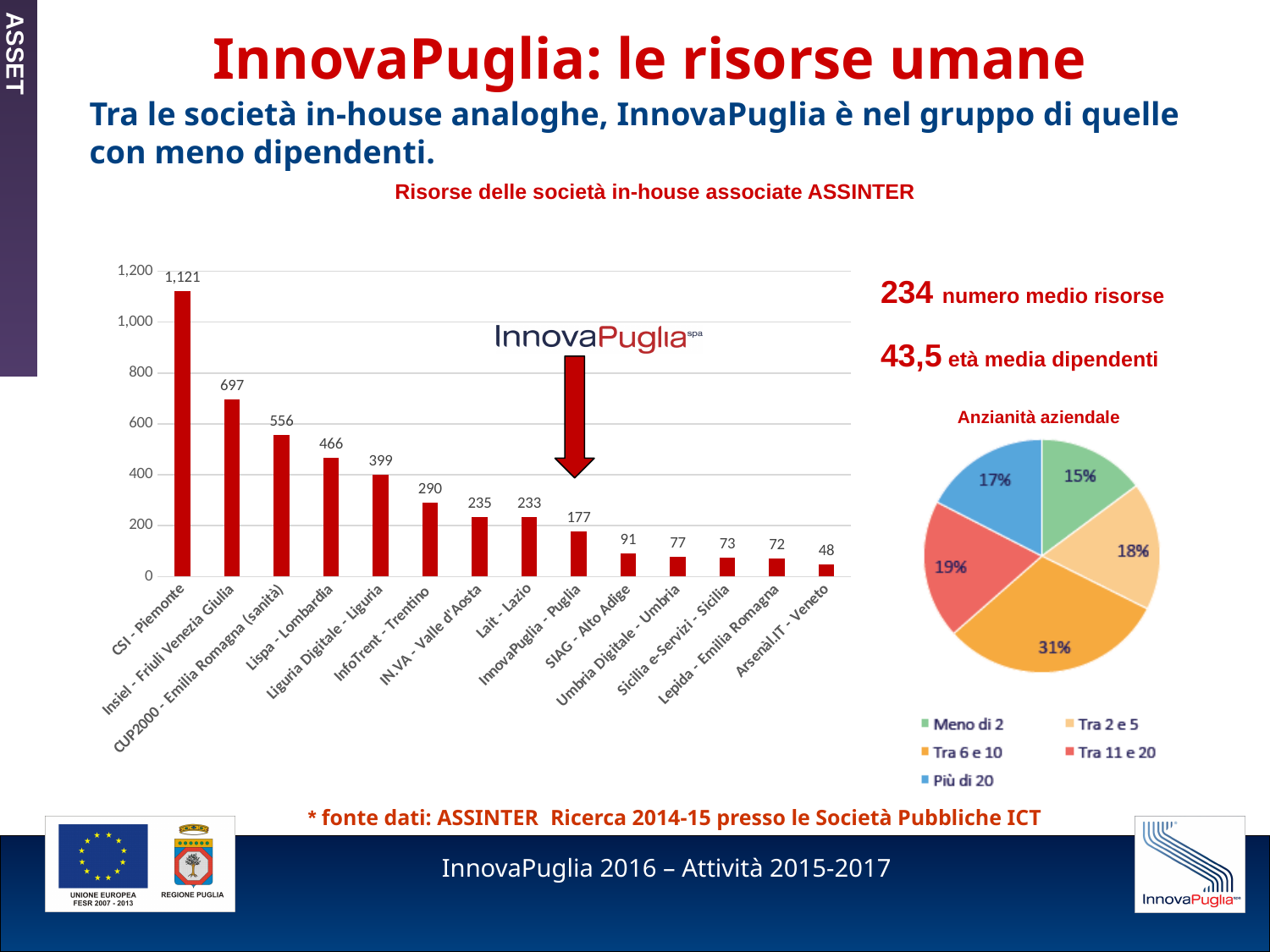
In the bar chart 'Risorse delle società in-house associate ASSINTER', which company has the lowest value? Arsenàl.IT - Veneto What kind of chart is 'Risorse delle società in-house associate ASSINTER'? Bar chart In the bar chart 'Risorse delle società in-house associate ASSINTER', what is the value for Lait - Lazio? 233 In the pie chart 'Anzianità aziendale', which category has the smallest share? Meno di 2 In the bar chart 'Risorse delle società in-house associate ASSINTER', what is the value for InnovaPuglia - Puglia? 177 In the bar chart 'Risorse delle società in-house associate ASSINTER', how many companies are shown? 14 In the bar chart 'Risorse delle società in-house associate ASSINTER', what is the difference between CSI - Piemonte and Insiel - Friuli Venezia Giulia? 424 In the bar chart 'Risorse delle società in-house associate ASSINTER', do the values rise or fall from left to right? Fall In the bar chart 'Risorse delle società in-house associate ASSINTER', which company has the highest value? CSI - Piemonte How many entries does the legend of the pie chart 'Anzianità aziendale' list? 5 In the pie chart 'Anzianità aziendale', what share does 'Tra 6 e 10' have? 31% In the bar chart 'Risorse delle società in-house associate ASSINTER', which is larger: Lispa - Lombardia or Liguria Digitale - Liguria? Lispa - Lombardia